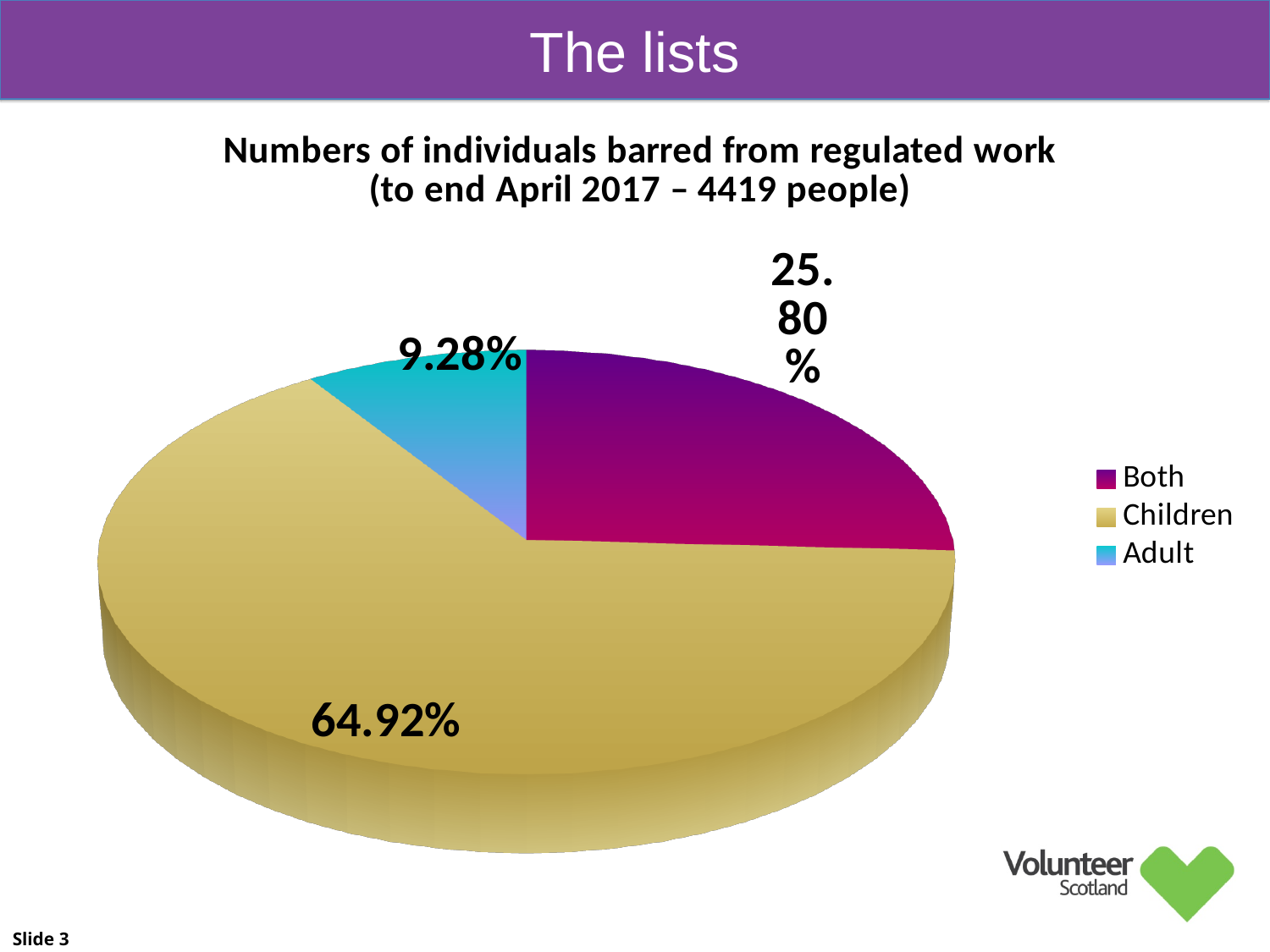
What share of the pie does the Adult slice represent? 9.28% What is the difference in percentage points between the Both slice and the Adult slice? 16.52 Which colour represents the Children category in the legend? gold Which category has the smallest slice of the pie? Adult What share of the pie does the Children slice represent? 64.92% What is the difference in percentage points between the Children slice and the Both slice? 39.12 Which category has the largest slice of the pie? Children Which is larger, the Both slice or the Adult slice? Both What is the title of the chart? Numbers of individuals barred from regulated work (to end April 2017 – 4419 people) What type of chart is shown on the slide? pie chart How many categories does the pie chart have? 3 What share of the pie does the Both slice represent? 25.80%